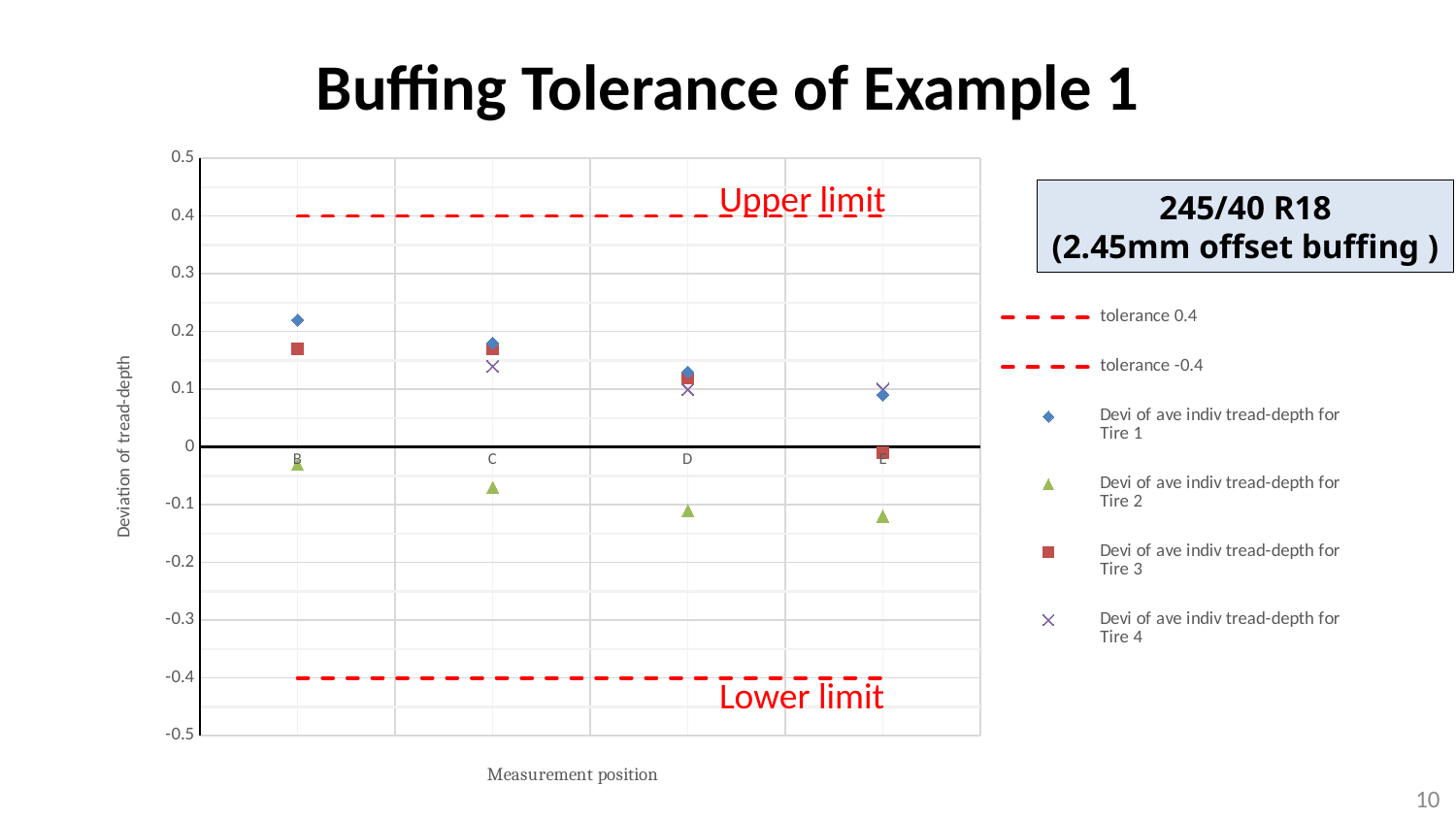
Do the deviation values for Tire 1 rise or fall from position B to position E? fall What is the title of the vertical axis? Deviation of tread-depth What kind of chart is shown on the slide? scatter chart Which is larger at position C: the deviation for Tire 1 or for Tire 4? Tire 1 How many entries does the legend list? 6 At which measurement position is the deviation for Tire 2 highest? B Is the deviation for Tire 2 at position C greater or less than 0? less At what value is the lower limit (tolerance) line drawn? -0.4 At what value is the upper limit (tolerance) line drawn? 0.4 How many measurement positions are shown on the x axis? 4 Is the deviation for Tire 1 at position B greater or less than 0.1? greater At which measurement position is the deviation for Tire 1 highest? B